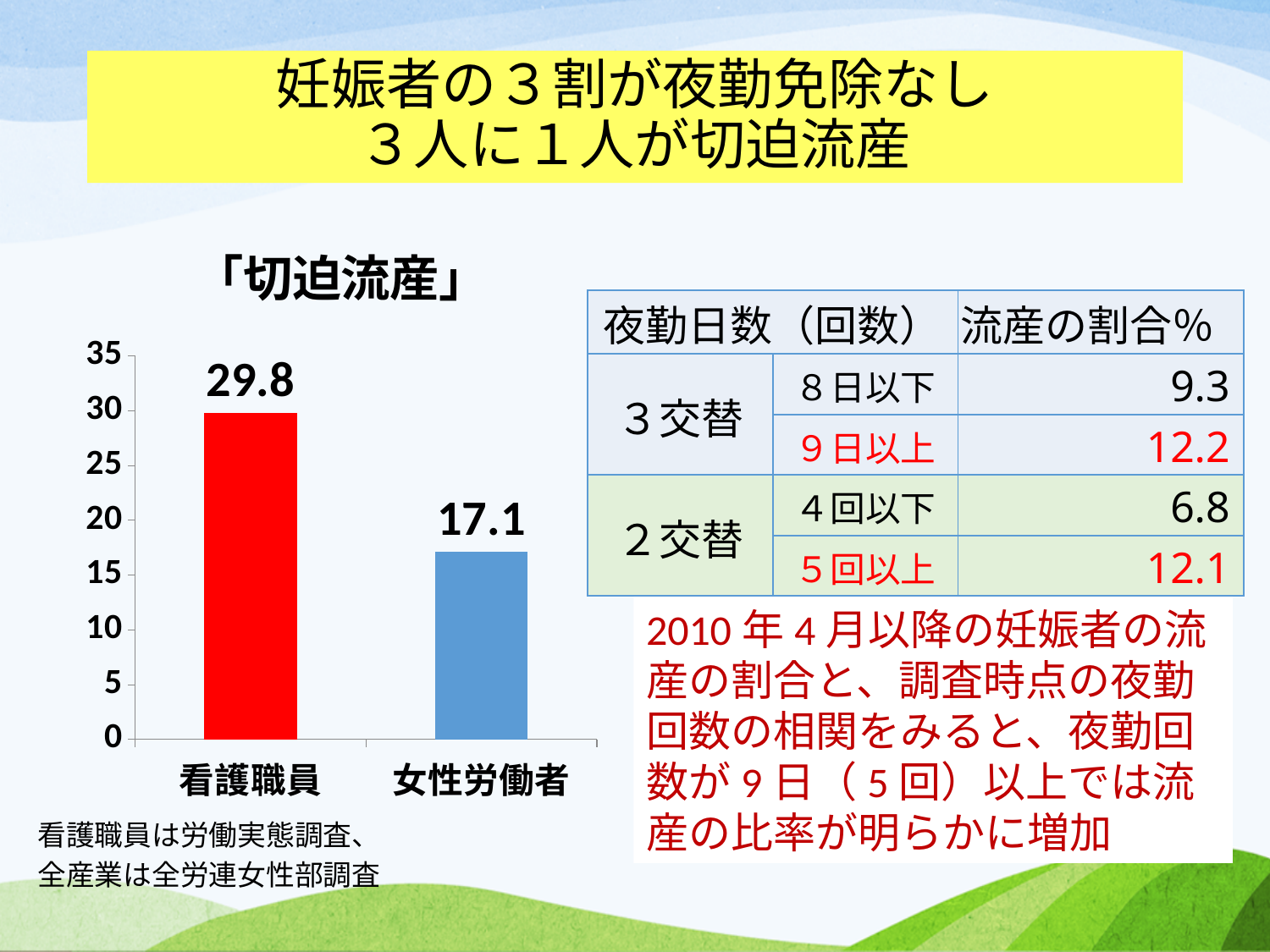
In the 「切迫流産」 chart, which is larger: the value for 看護職員 or for 女性労働者? 看護職員 Is the value for 看護職員 in the 「切迫流産」 chart greater or less than 25? greater What is the value for 女性労働者 in the 「切迫流産」 chart? 17.1 What colour is the bar for 看護職員 in the 「切迫流産」 chart? red Which category has the highest value in the 「切迫流産」 chart? 看護職員 What is the title of the bar chart on the slide? 「切迫流産」 What is the difference between the values for 看護職員 and 女性労働者 in the 「切迫流産」 chart? 12.7 Which category has the lowest value in the 「切迫流産」 chart? 女性労働者 What is the value for 看護職員 in the 「切迫流産」 chart? 29.8 Is the value for 女性労働者 in the 「切迫流産」 chart greater or less than 20? less How many categories are shown in the 「切迫流産」 chart? 2 What kind of chart is the 「切迫流産」 chart? bar chart